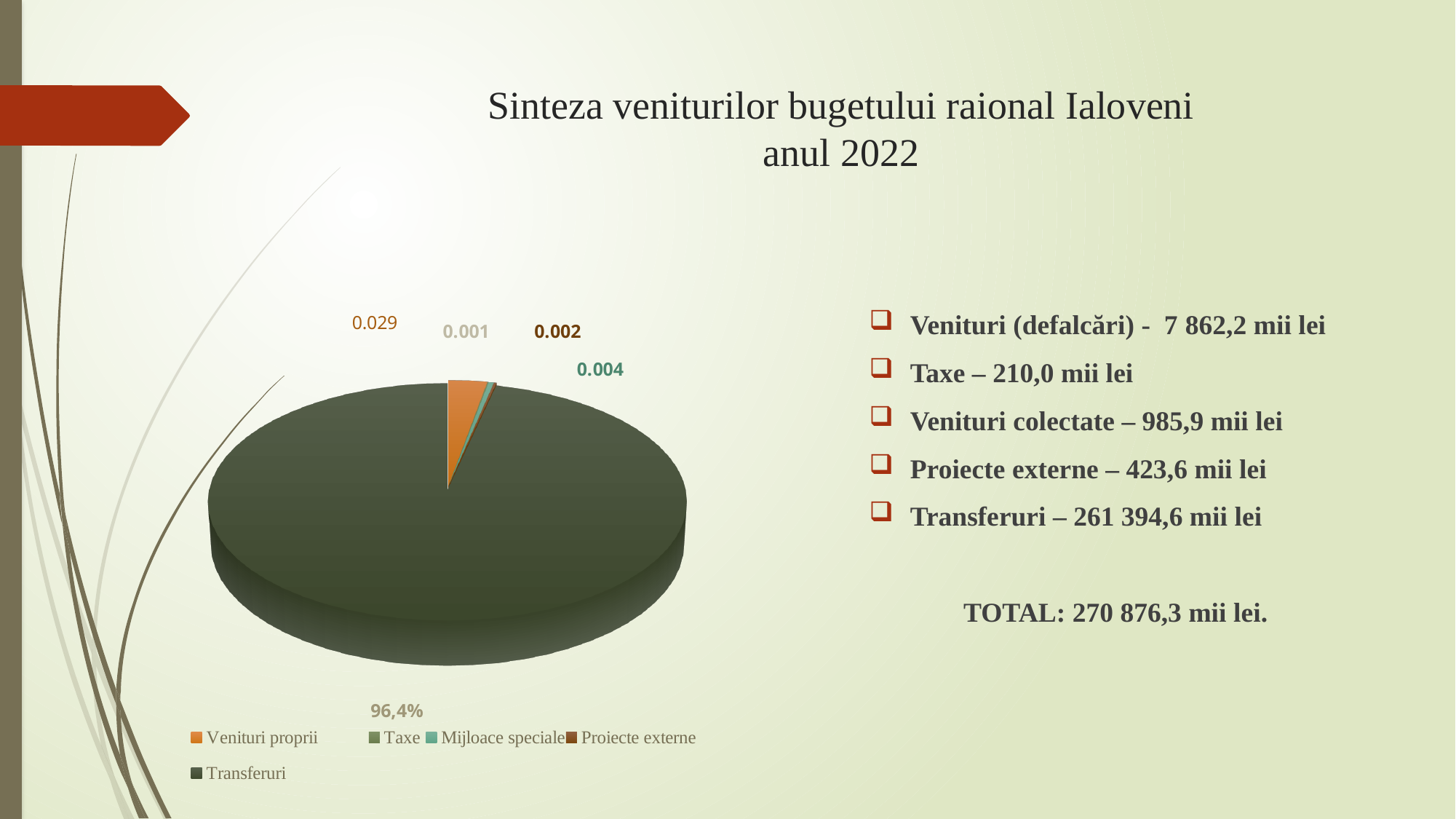
What kind of chart is shown on the slide? pie chart What is the data label shown for the Venituri proprii slice? 0.029 How many categories does the legend of the pie chart list? 5 What is the data label shown for the Proiecte externe slice? 0.002 What is the data label shown for the Transferuri slice? 96,4% What is the title of the slide containing the pie chart? Sinteza veniturilor bugetului raional Ialoveni anul 2022 What is the data label shown for the Mijloace speciale slice? 0.004 Which slice is larger, Venituri proprii or Mijloace speciale? Venituri proprii Which category has the largest slice in the pie chart? Transferuri What colour is the Venituri proprii slice in the pie chart? orange What is the data label shown for the Taxe slice? 0.001 Which slice is larger, Venituri proprii or Transferuri? Transferuri